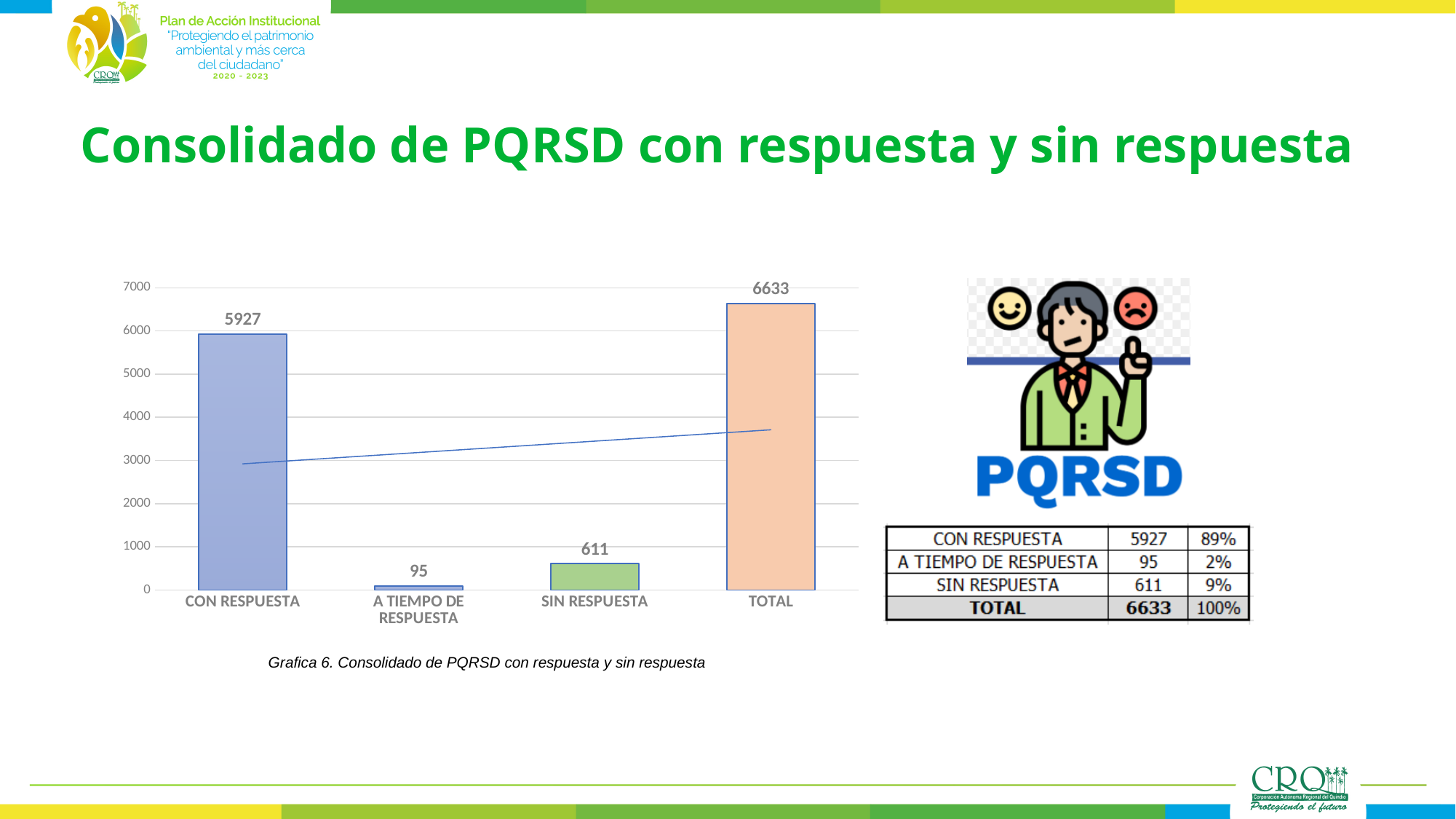
How many categories are shown on the x axis? 4 What is the difference between the values for TOTAL and CON RESPUESTA? 706 What is the value for TOTAL? 6633 Which category has the highest value? TOTAL What is the value for A TIEMPO DE RESPUESTA? 95 Which category has the lowest value? A TIEMPO DE RESPUESTA Which is larger, the value for SIN RESPUESTA or the value for A TIEMPO DE RESPUESTA? SIN RESPUESTA What kind of chart is shown? bar chart What is the value for CON RESPUESTA? 5927 What is the difference between the values for SIN RESPUESTA and A TIEMPO DE RESPUESTA? 516 Is the value for CON RESPUESTA greater or less than 5000? greater What is the value for SIN RESPUESTA? 611